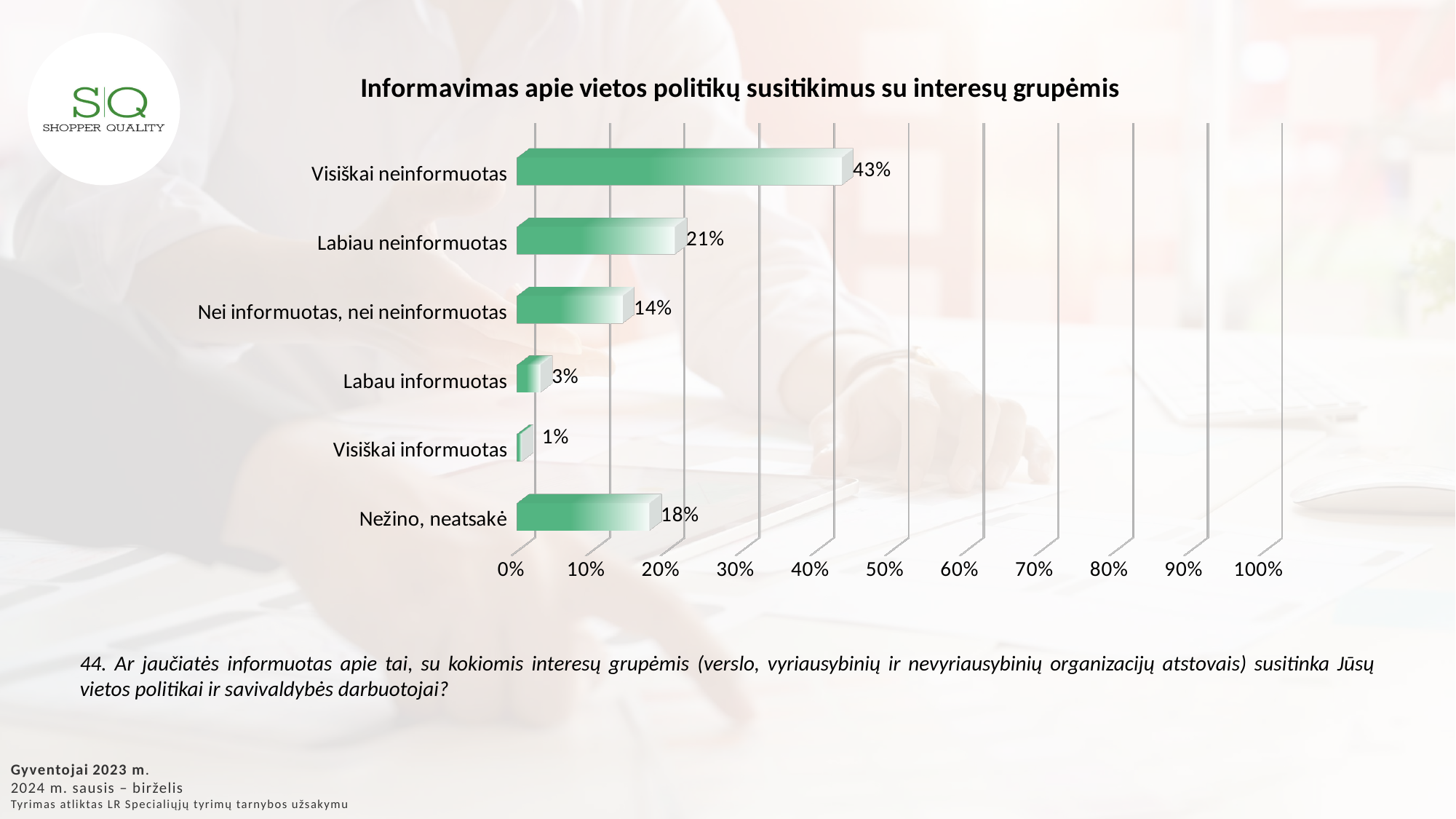
What is the value for "Nežino, neatsakė"? 18% How many categories are shown in the chart? 6 What is the value for "Labiau neinformuotas"? 21% Which category has the lowest value? Visiškai informuotas What is the difference between "Visiškai neinformuotas" and "Labiau neinformuotas"? 22% Is the value for "Visiškai neinformuotas" greater or less than 40%? greater What is the value for "Visiškai neinformuotas"? 43% What is the title of the chart? Informavimas apie vietos politikų susitikimus su interesų grupėmis What is the value for "Nei informuotas, nei neinformuotas"? 14% Which category has the highest value? Visiškai neinformuotas Which is larger, "Nežino, neatsakė" or "Nei informuotas, nei neinformuotas"? Nežino, neatsakė What kind of chart is shown on the slide? Bar chart